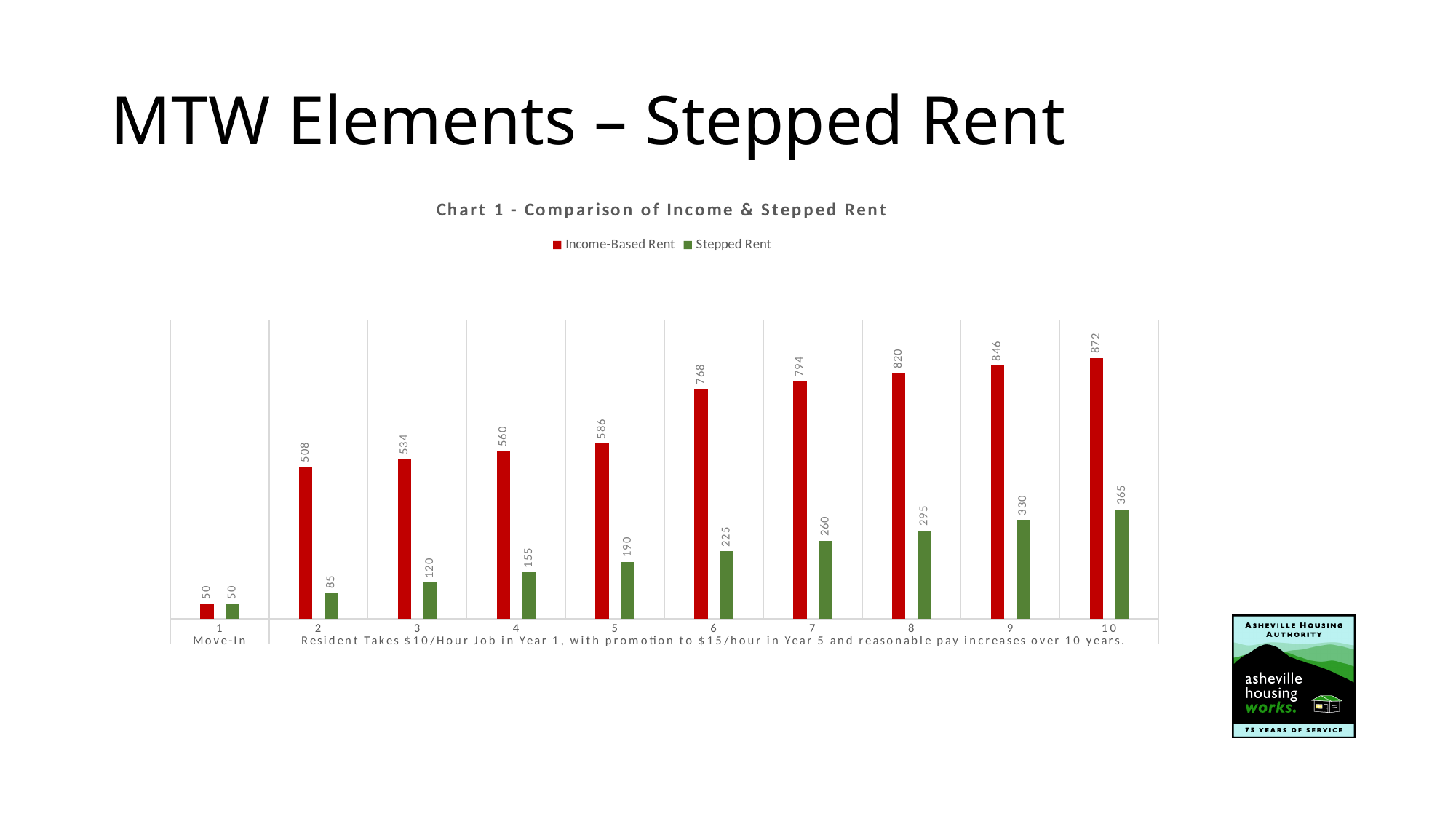
What is the difference between the Stepped Rent in year 9 and year 8? 35 Which year has the highest Income-Based Rent? 10 What is the difference between Income-Based Rent and Stepped Rent in year 10? 507 What is the Income-Based Rent value for year 6? 768 How many series does the legend list? 2 How many years (categories) are shown on the x axis? 10 What kind of chart is shown? Bar chart Which is larger in year 5, the Income-Based Rent or the Stepped Rent? Income-Based Rent What is the Stepped Rent value for year 10? 365 What is the Stepped Rent value for year 4? 155 Does the Stepped Rent rise or fall from year 1 to year 10? Rise Which year has the lowest Stepped Rent? 1